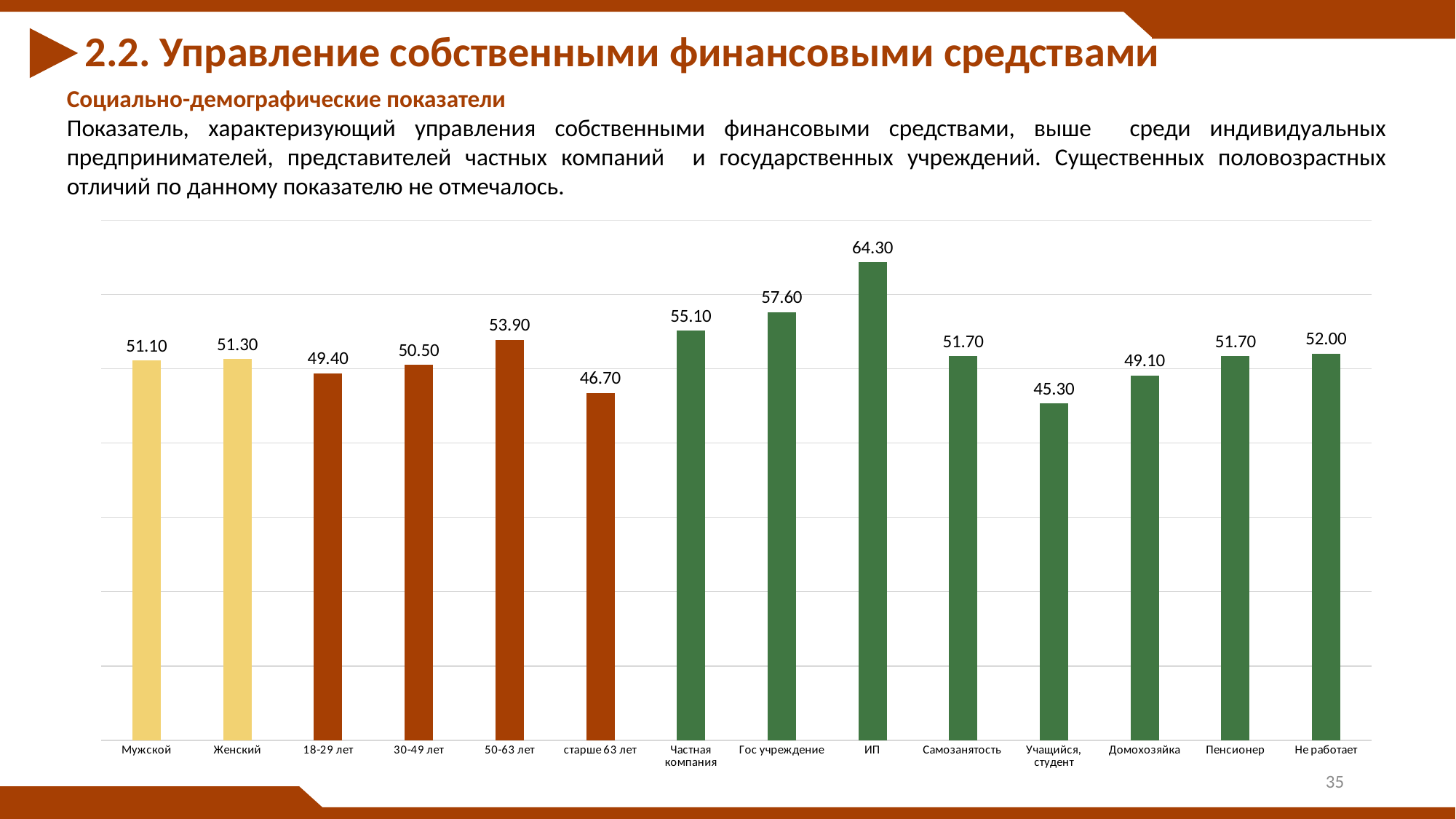
What is the value for Домохозяйка? 49.10 What is the difference between the values for ИП and Гос учреждение? 6.70 How many different bar colours are used in the chart? 3 What is the value for старше 63 лет? 46.70 What is the value for Гос учреждение? 57.60 Which is larger, the value for Частная компания or the value for Самозанятость? Частная компания Which category has the highest value? ИП What is the difference between the values for 50-63 лет and старше 63 лет? 7.20 Which category has the lowest value? Учащийся, студент How many categories are shown on the x axis? 14 What kind of chart is shown on the slide? Bar chart What is the value for ИП? 64.30